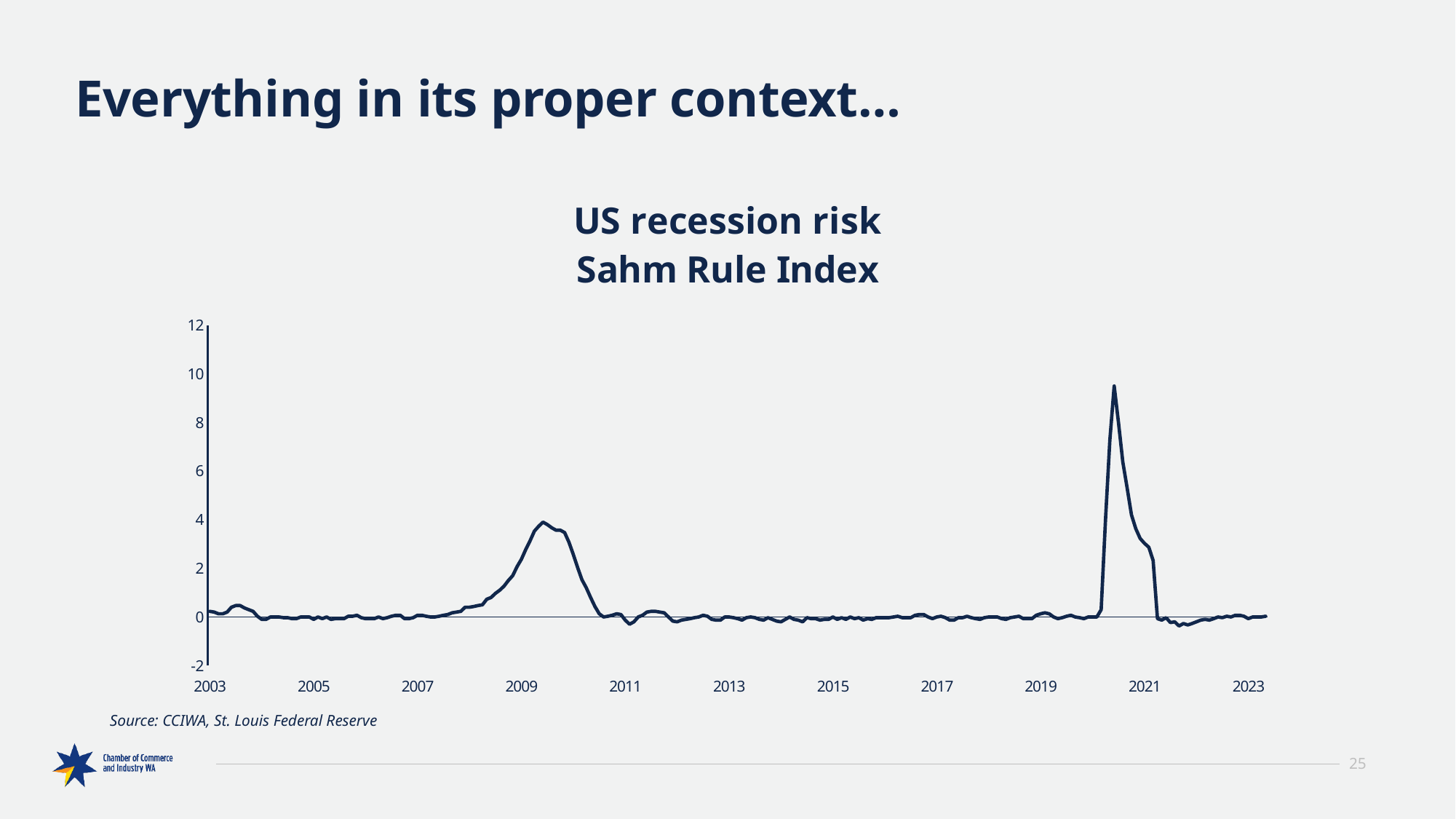
How many year labels are shown on the horizontal axis? 11 What is the highest value shown on the vertical axis? 12 Is the peak value of the Sahm Rule Index around 2009 greater or less than 2? greater Does the Sahm Rule Index rise or fall between 2007 and 2009? rise Is the peak value of the Sahm Rule Index around 2009 greater or less than 6? less Does the Sahm Rule Index rise or fall between 2009 and 2011? fall In which year does the Sahm Rule Index reach its highest value on the chart? 2020 Which peak of the Sahm Rule Index is higher, the one around 2009 or the one around 2020? the one around 2020 Is the value of the Sahm Rule Index in 2015 greater or less than 2? less What kind of chart is shown on the slide? line chart What is the title of the chart? US recession risk Sahm Rule Index